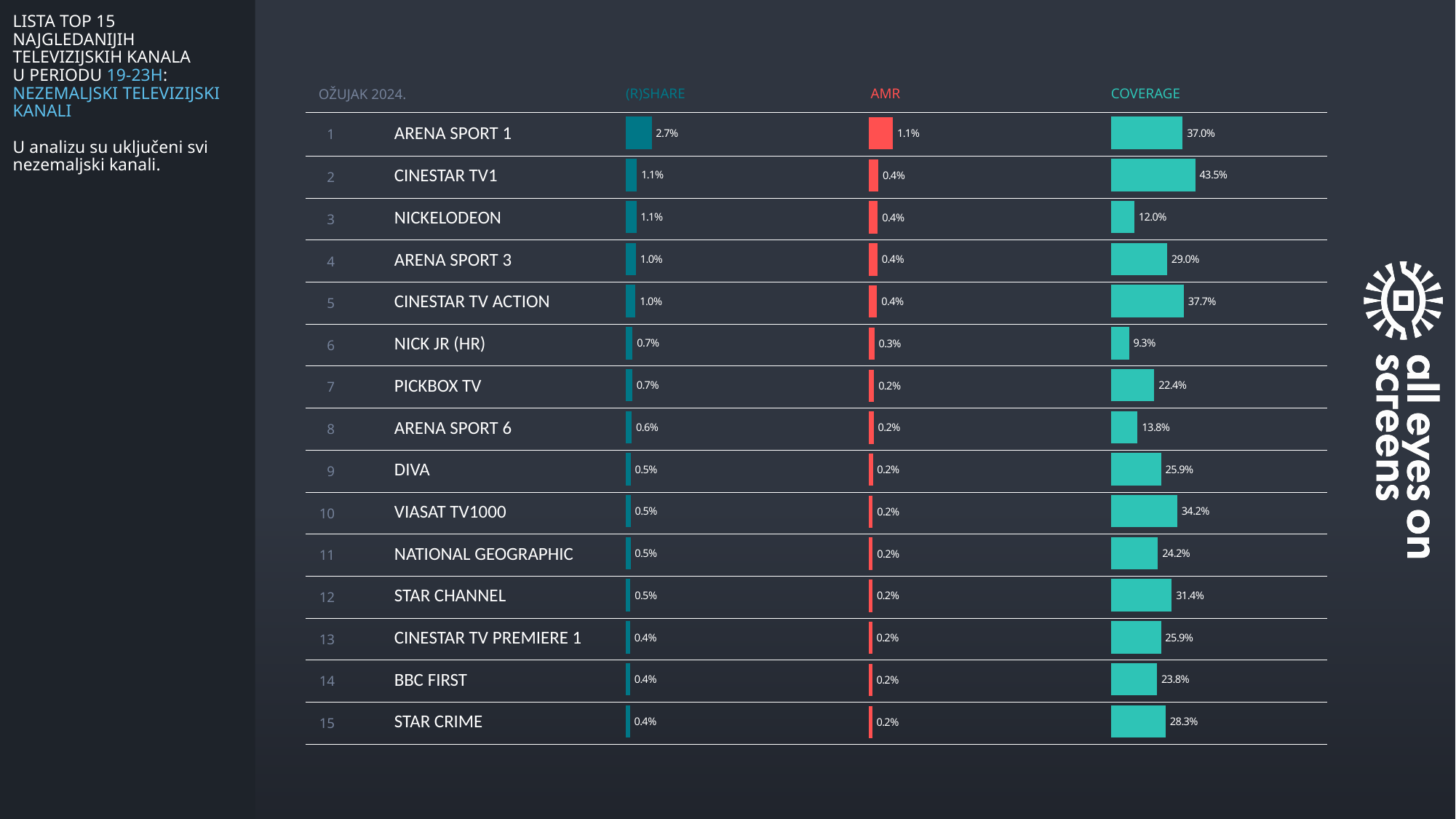
What is the AMR value for NICKELODEON? 0.4% How many channels are listed in the table? 15 What colour are the AMR bars? Red Which channel has the highest AMR value? ARENA SPORT 1 Which channel has the highest COVERAGE value? CINESTAR TV1 Which channel has the lowest COVERAGE value? NICK JR (HR) Which has a higher COVERAGE value, VIASAT TV1000 or STAR CHANNEL? VIASAT TV1000 What is the (R)SHARE value for ARENA SPORT 1? 2.7% What is the COVERAGE value for CINESTAR TV1? 43.5% What is the COVERAGE value for NICK JR (HR)? 9.3% What is the difference in COVERAGE between CINESTAR TV1 and ARENA SPORT 1? 6.5% What kind of chart is used to show the (R)SHARE, AMR and COVERAGE values? Bar chart